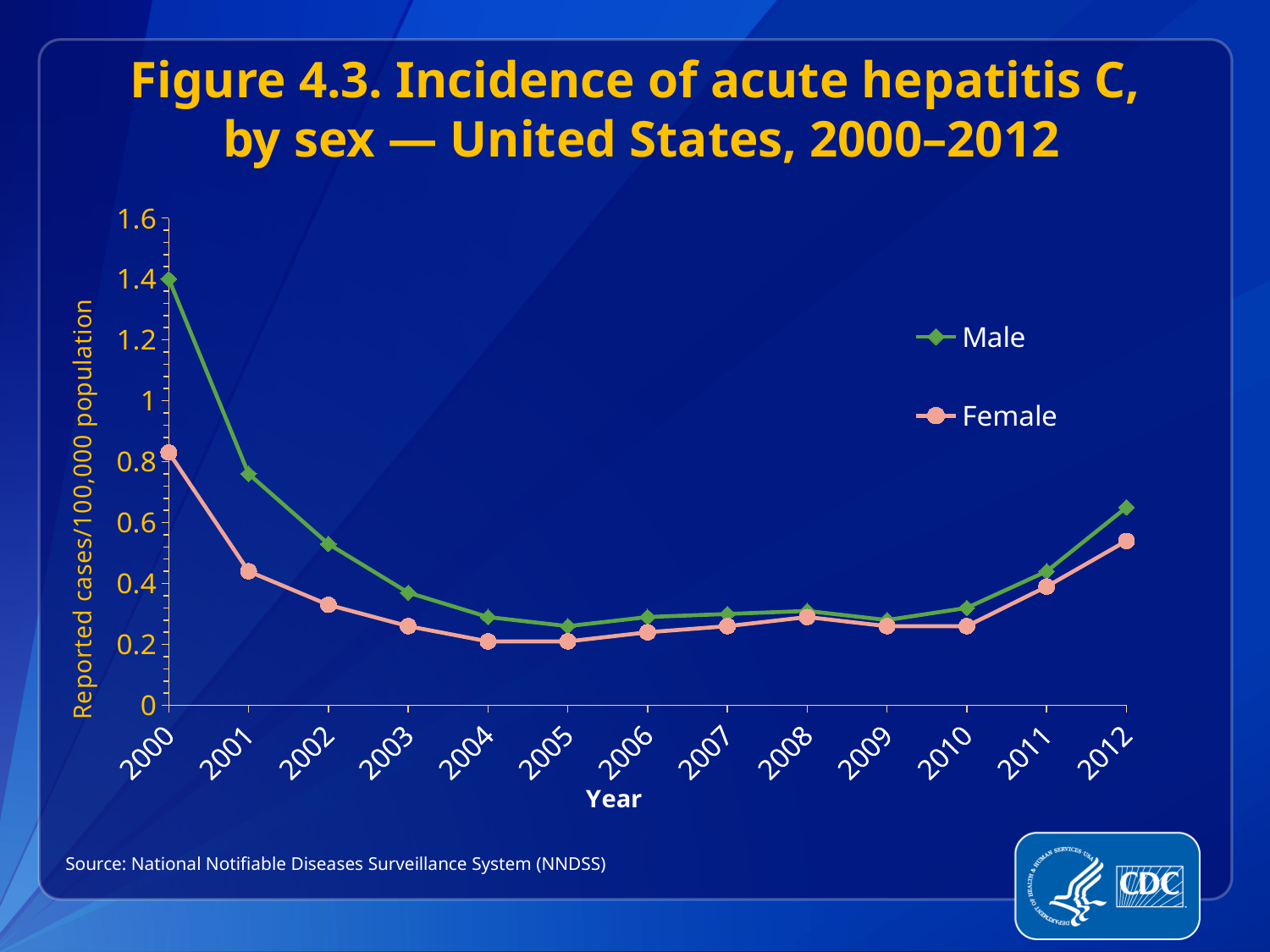
How many years are plotted along the x axis? 13 What is the label on the y axis? Reported cases/100,000 population Is the Male value for 2001 greater or less than 0.8? less Is the Female value for 2000 greater or less than 1? less In which year is the Male incidence rate highest? 2000 What kind of chart is shown on the slide? Line chart In which year is the Female incidence rate highest? 2000 Do the Male values rise or fall from 2000 to 2004? Fall How many series does the legend list? 2 Is the Male value for 2012 greater or less than 0.6? greater Which series has the higher value in 2000, Male or Female? Male